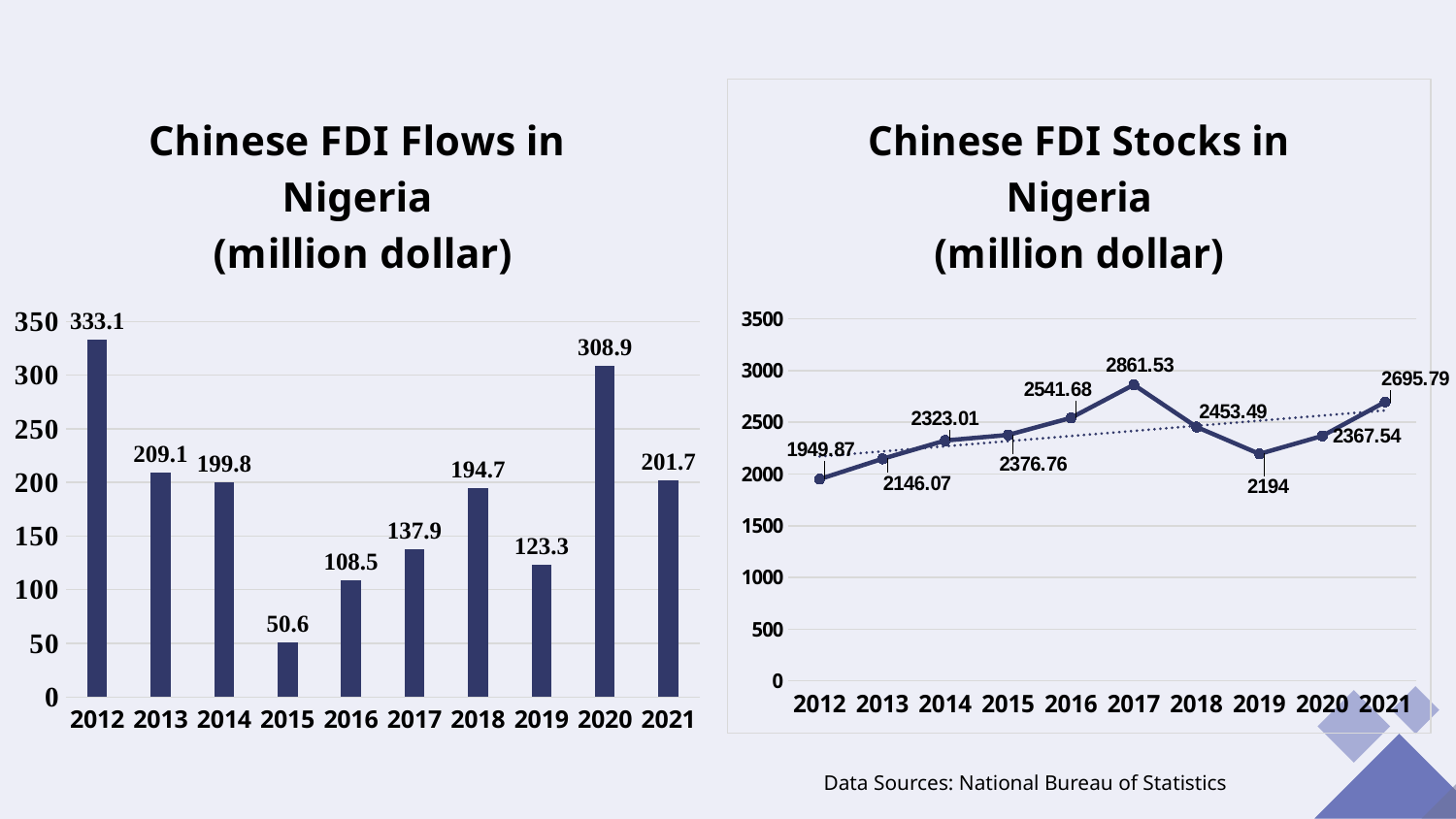
In the 'Chinese FDI Flows in Nigeria' chart, which is larger, the value for 2013 or the value for 2014? 2013 In the 'Chinese FDI Flows in Nigeria' chart, what is the value for 2015? 50.6 In the 'Chinese FDI Flows in Nigeria' chart, what is the difference between the values for 2020 and 2021? 107.2 In the 'Chinese FDI Stocks in Nigeria' chart, what is the difference between the values for 2017 and 2018? 408.04 How many years are shown in the 'Chinese FDI Flows in Nigeria' chart? 10 In the 'Chinese FDI Flows in Nigeria' chart, which year has the lowest value? 2015 In the 'Chinese FDI Stocks in Nigeria' chart, is the value for 2019 greater or less than 2500? less What kind of chart is the 'Chinese FDI Flows in Nigeria' chart? bar chart In the 'Chinese FDI Flows in Nigeria' chart, which year has the highest value? 2012 In the 'Chinese FDI Stocks in Nigeria' chart, which year has the lowest value? 2012 What kind of chart is the 'Chinese FDI Stocks in Nigeria' chart? line chart In the 'Chinese FDI Stocks in Nigeria' chart, what is the value for 2017? 2861.53